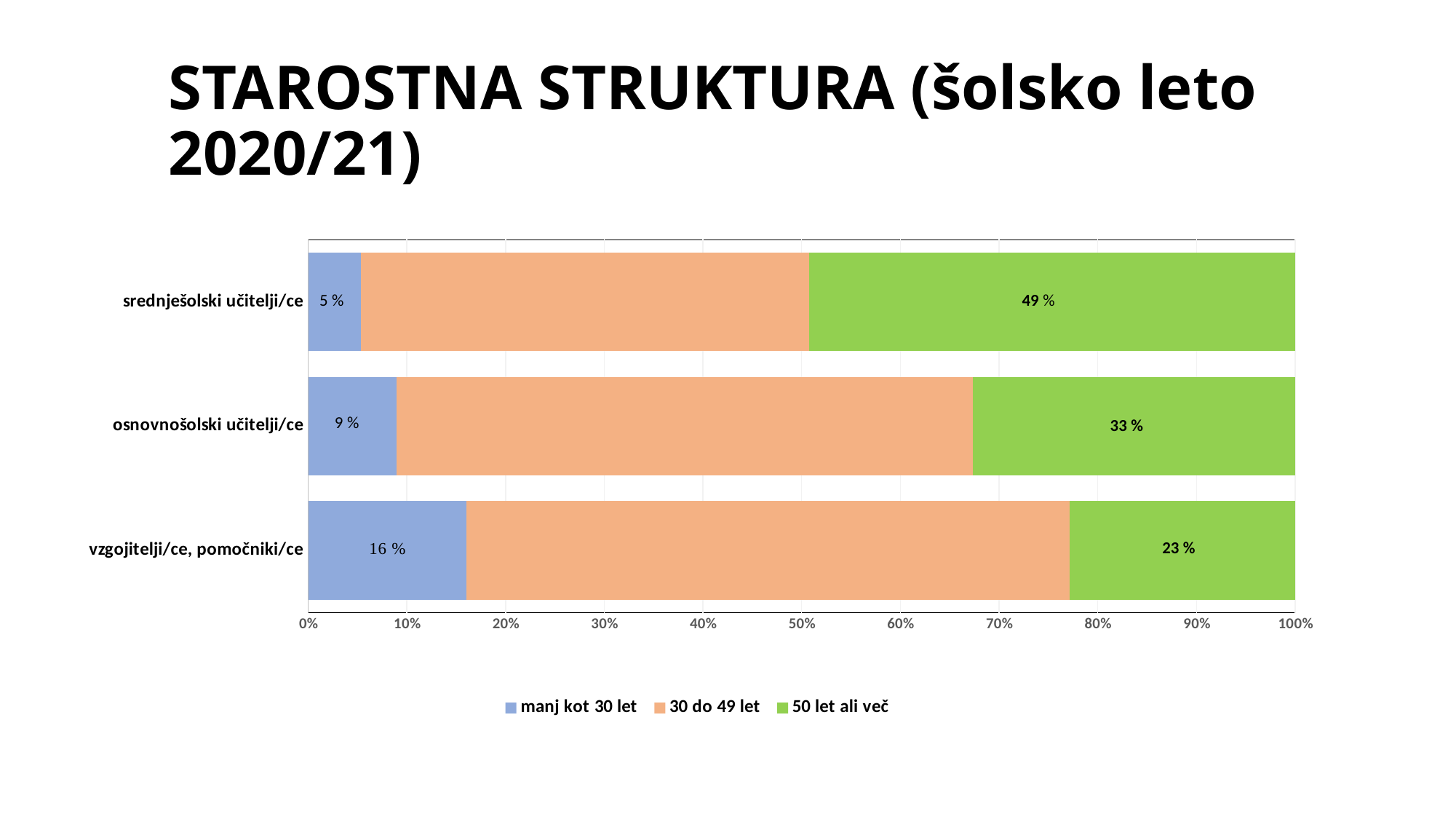
How many categories are shown on the chart? 3 Which category has the highest value for '50 let ali več'? srednješolski učitelji/ce How many series does the legend list? 3 Which is larger: the 'manj kot 30 let' value for osnovnošolski učitelji/ce or for vzgojitelji/ce, pomočniki/ce? vzgojitelji/ce, pomočniki/ce What is the value for 'manj kot 30 let' for vzgojitelji/ce, pomočniki/ce? 16 % What is the value for 'manj kot 30 let' for srednješolski učitelji/ce? 5 % What is the difference between the '50 let ali več' values for srednješolski učitelji/ce and vzgojitelji/ce, pomočniki/ce? 26 % What is the value for '50 let ali več' for srednješolski učitelji/ce? 49 % Is the '30 do 49 let' share for osnovnošolski učitelji/ce greater or less than 50%? greater Which category has the lowest value for 'manj kot 30 let'? srednješolski učitelji/ce What kind of chart is shown on the slide? stacked bar chart What is the value for '50 let ali več' for osnovnošolski učitelji/ce? 33 %